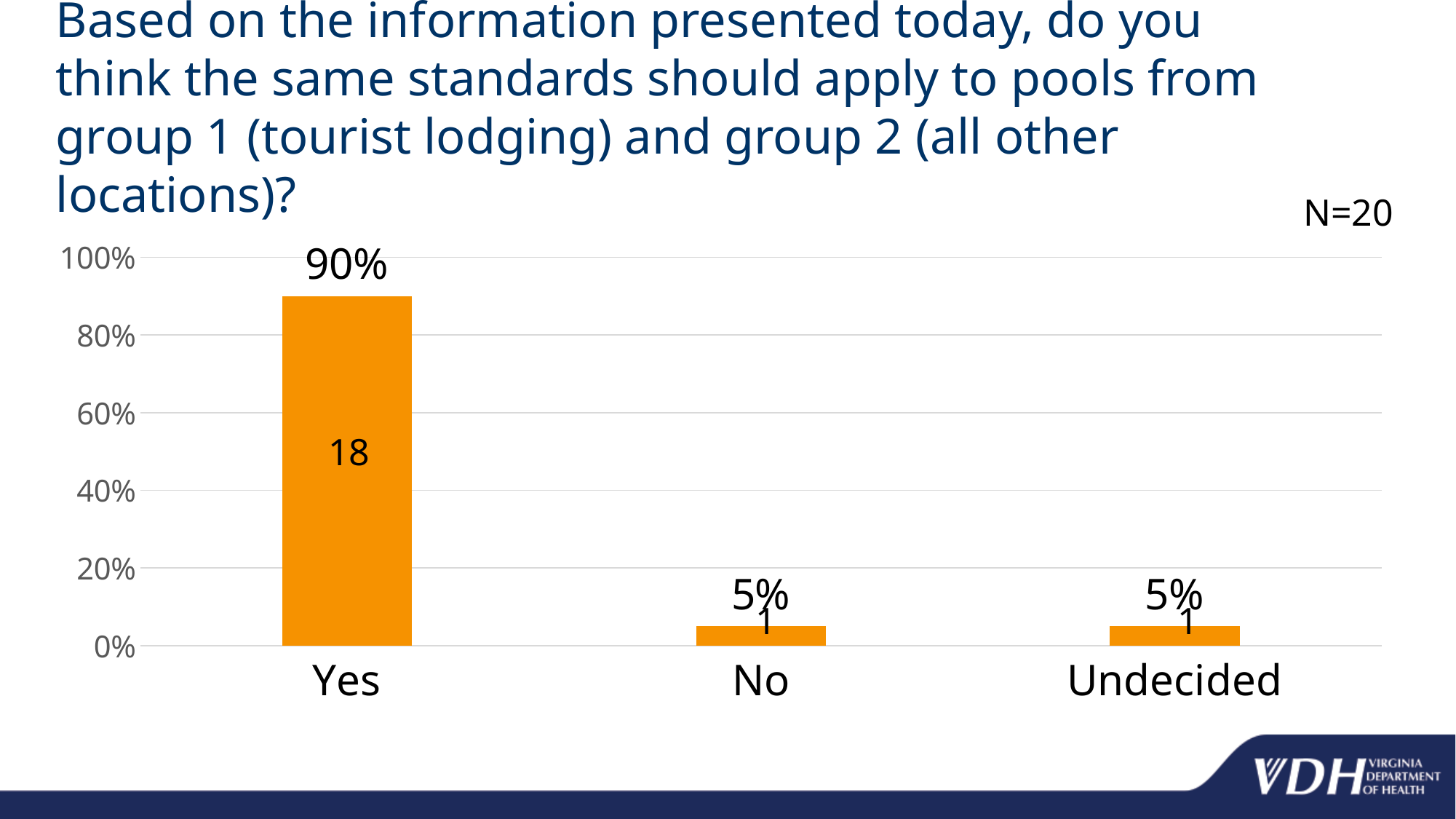
What is the total number of respondents (N) shown on the slide? 20 What percentage of respondents answered Yes? 90% How many respondents answered Yes? 18 What kind of chart is shown on the slide? Bar chart What percentage of respondents answered No? 5% Which is larger, the value for Yes or the value for Undecided? Yes How many respondents answered Undecided? 1 How many response categories are shown on the x axis? 3 What is the difference in percentage points between Yes and No? 85 percentage points Is the value for No greater or less than 20%? less Is the value for Yes greater or less than 80%? greater Which response category has the highest percentage? Yes